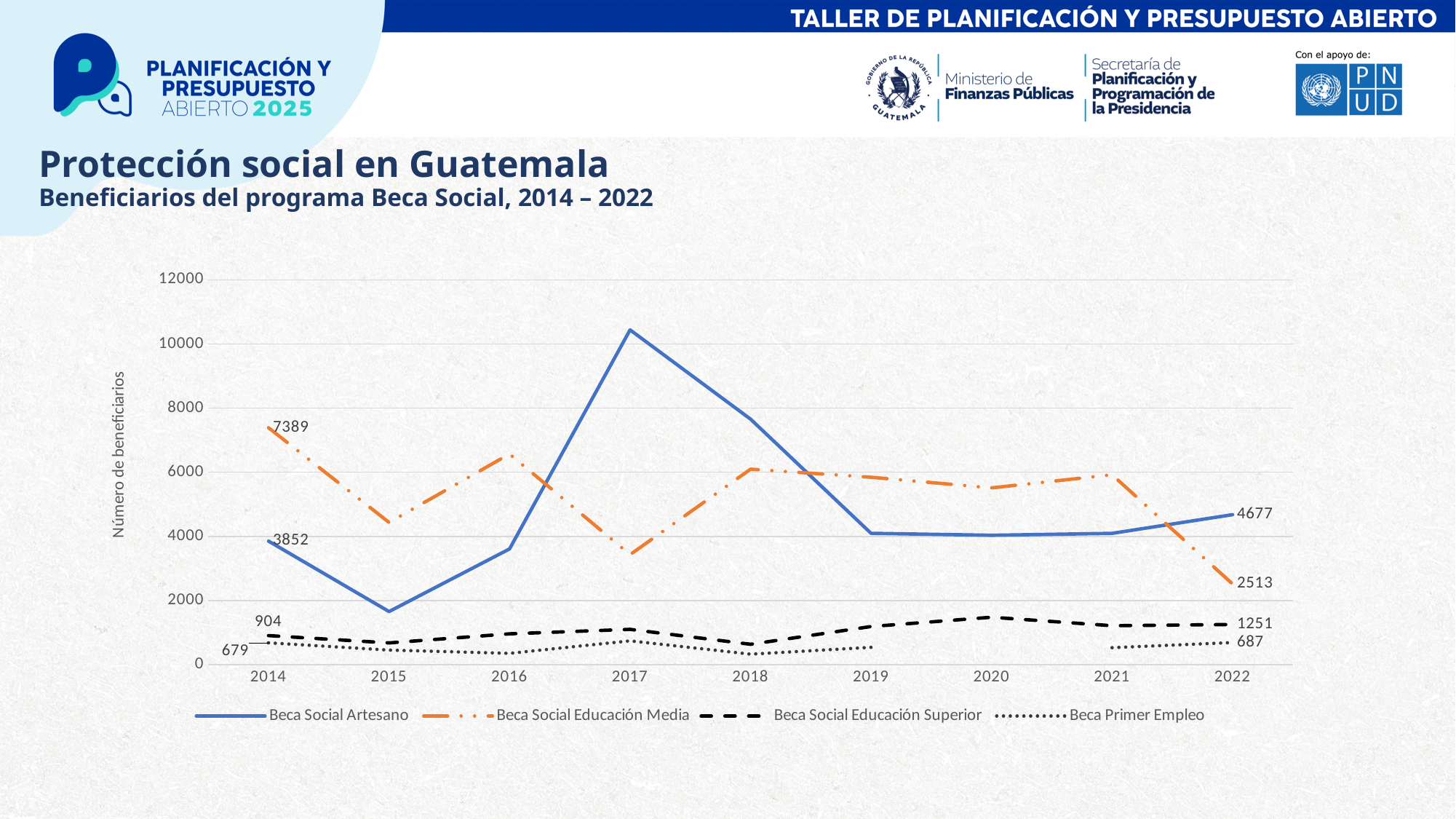
In 2014, which series had more beneficiaries: Beca Social Artesano or Beca Social Educación Media? Beca Social Educación Media Is the value for Beca Social Artesano in 2017 greater or less than 10000? greater What is the value for Beca Social Educación Superior in 2022? 1251 What is the value for Beca Social Educación Media in 2022? 2513 What is the difference between the Beca Social Educación Media values in 2014 and 2022? 4876 In which year does Beca Social Artesano reach its highest value? 2017 What is the value for Beca Primer Empleo in 2014? 679 What is the value for Beca Social Artesano in 2022? 4677 By how much did Beca Social Artesano increase from 2014 to 2022? 825 What is the value for Beca Social Educación Media in 2014? 7389 What is the value for Beca Social Artesano in 2014? 3852 How many series does the legend list? 4